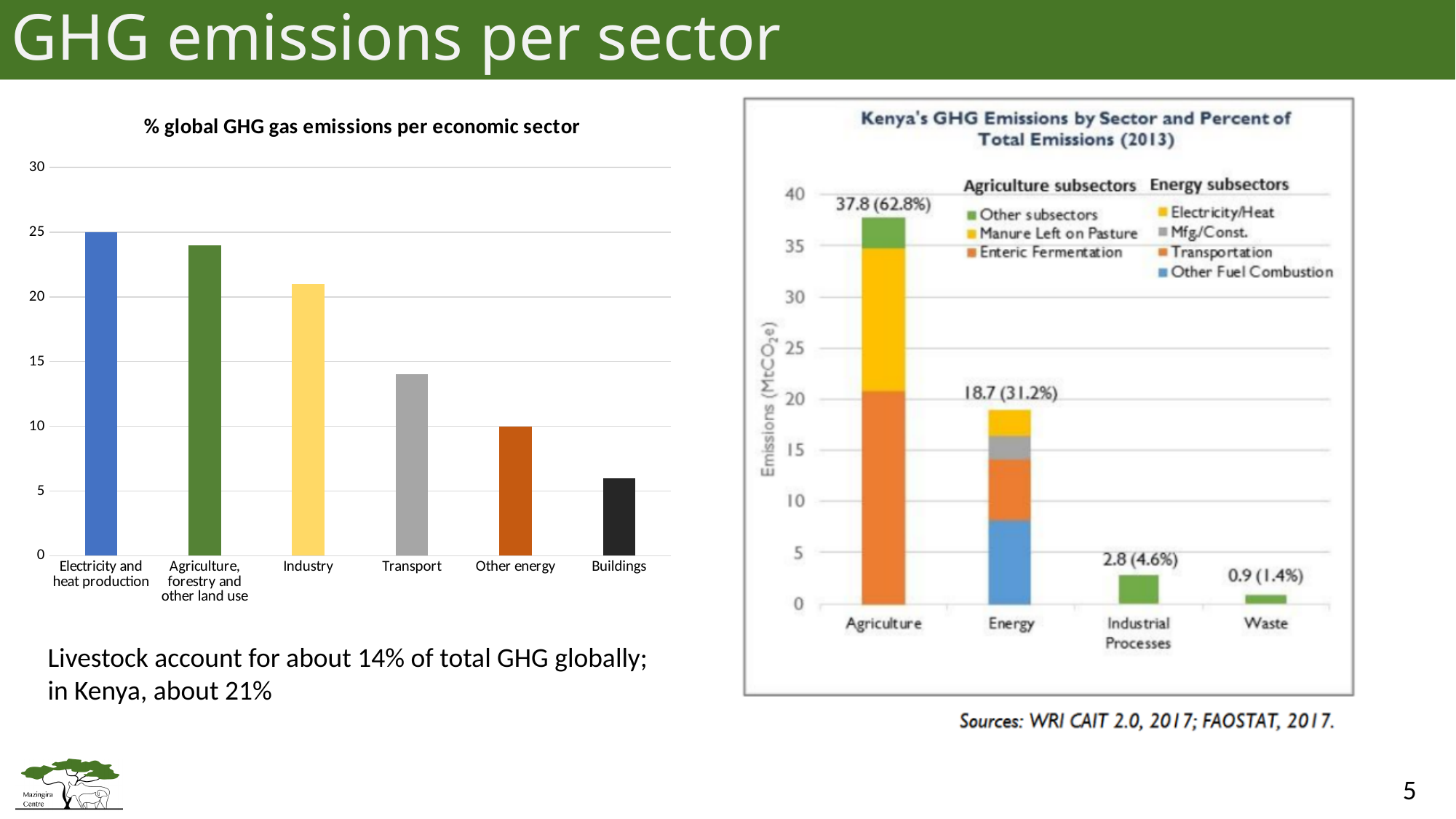
In the left chart '% global GHG gas emissions per economic sector', which sector has the highest value? Electricity and heat production In the right chart 'Kenya's GHG Emissions by Sector and Percent of Total Emissions (2013)', which sector has the lowest emissions? Waste In the right chart 'Kenya's GHG Emissions by Sector and Percent of Total Emissions (2013)', what is the value labelled for Energy? 18.7 (31.2%) In the left chart '% global GHG gas emissions per economic sector', which sector has the lowest value? Buildings What kind of chart is the left chart '% global GHG gas emissions per economic sector'? Bar chart In the right chart 'Kenya's GHG Emissions by Sector and Percent of Total Emissions (2013)', what is the total emissions value labelled for Agriculture? 37.8 (62.8%) In the left chart '% global GHG gas emissions per economic sector', which is larger: Industry or Transport? Industry In the right chart 'Kenya's GHG Emissions by Sector and Percent of Total Emissions (2013)', what is the difference in MtCO2e between Agriculture and Energy? 19.1 In the left chart '% global GHG gas emissions per economic sector', is the value for Transport greater or less than 15? less In the left chart '% global GHG gas emissions per economic sector', is the value for Industry greater or less than 20? greater How many legend entries are listed in the right chart 'Kenya's GHG Emissions by Sector and Percent of Total Emissions (2013)'? 7 How many sectors are shown in the left chart '% global GHG gas emissions per economic sector'? 6